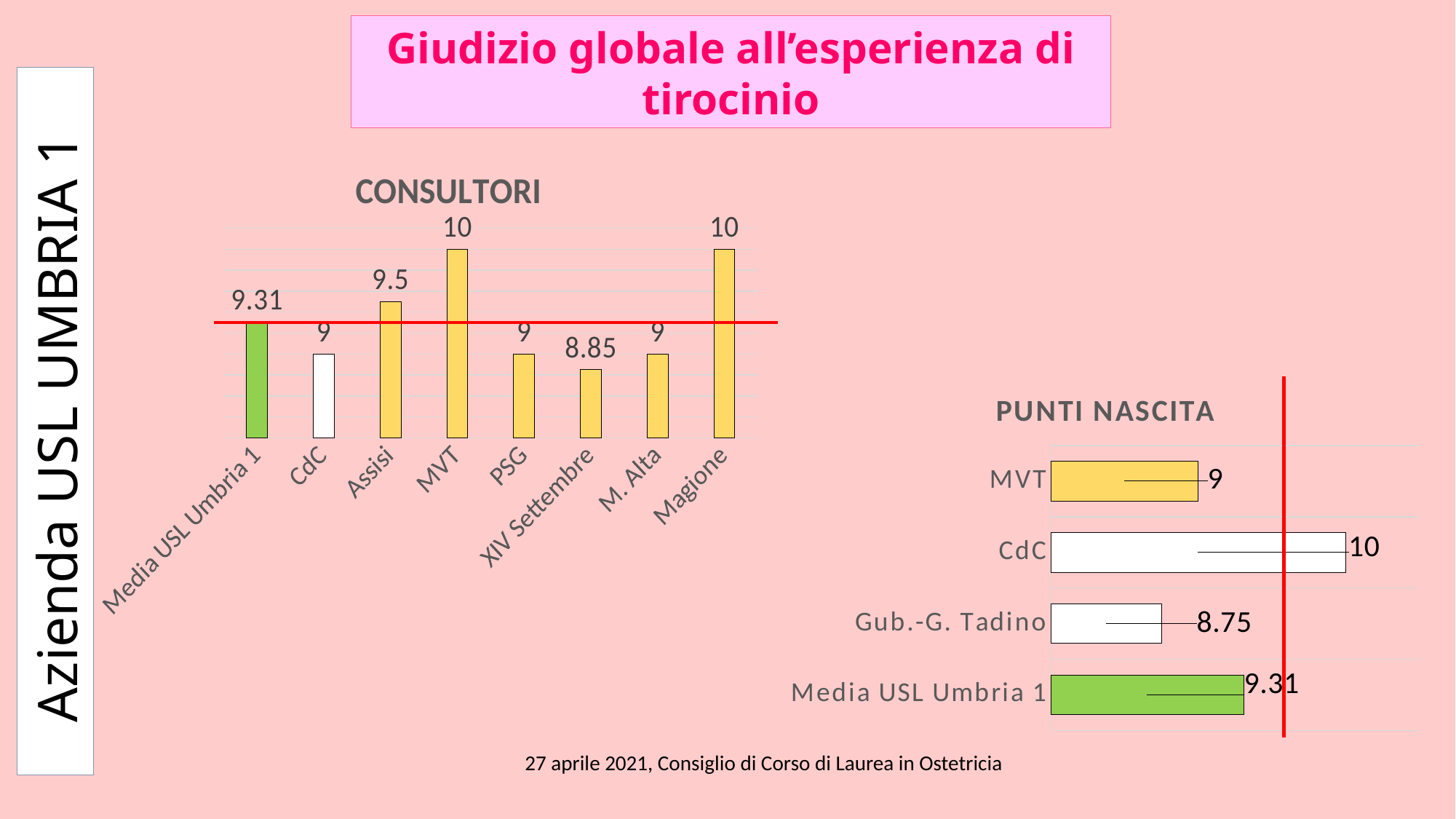
In the CONSULTORI chart, what is the difference between the values for MVT and XIV Settembre? 1.15 In the CONSULTORI chart, which is larger, the value for Assisi or the value for PSG? Assisi What kind of chart is the PUNTI NASCITA chart? Bar chart In the PUNTI NASCITA chart, what is the value for Gub.-G. Tadino? 8.75 In the CONSULTORI chart, what is the value for Assisi? 9.5 In the CONSULTORI chart, what is the value for Media USL Umbria 1? 9.31 In the CONSULTORI chart, what is the value for XIV Settembre? 8.85 In the PUNTI NASCITA chart, which category has the highest value? CdC In the PUNTI NASCITA chart, what is the difference between the values for CdC and MVT? 1 In the CONSULTORI chart, which category has the lowest value? XIV Settembre In the PUNTI NASCITA chart, how many categories are shown? 4 In the CONSULTORI chart, how many categories are shown? 8